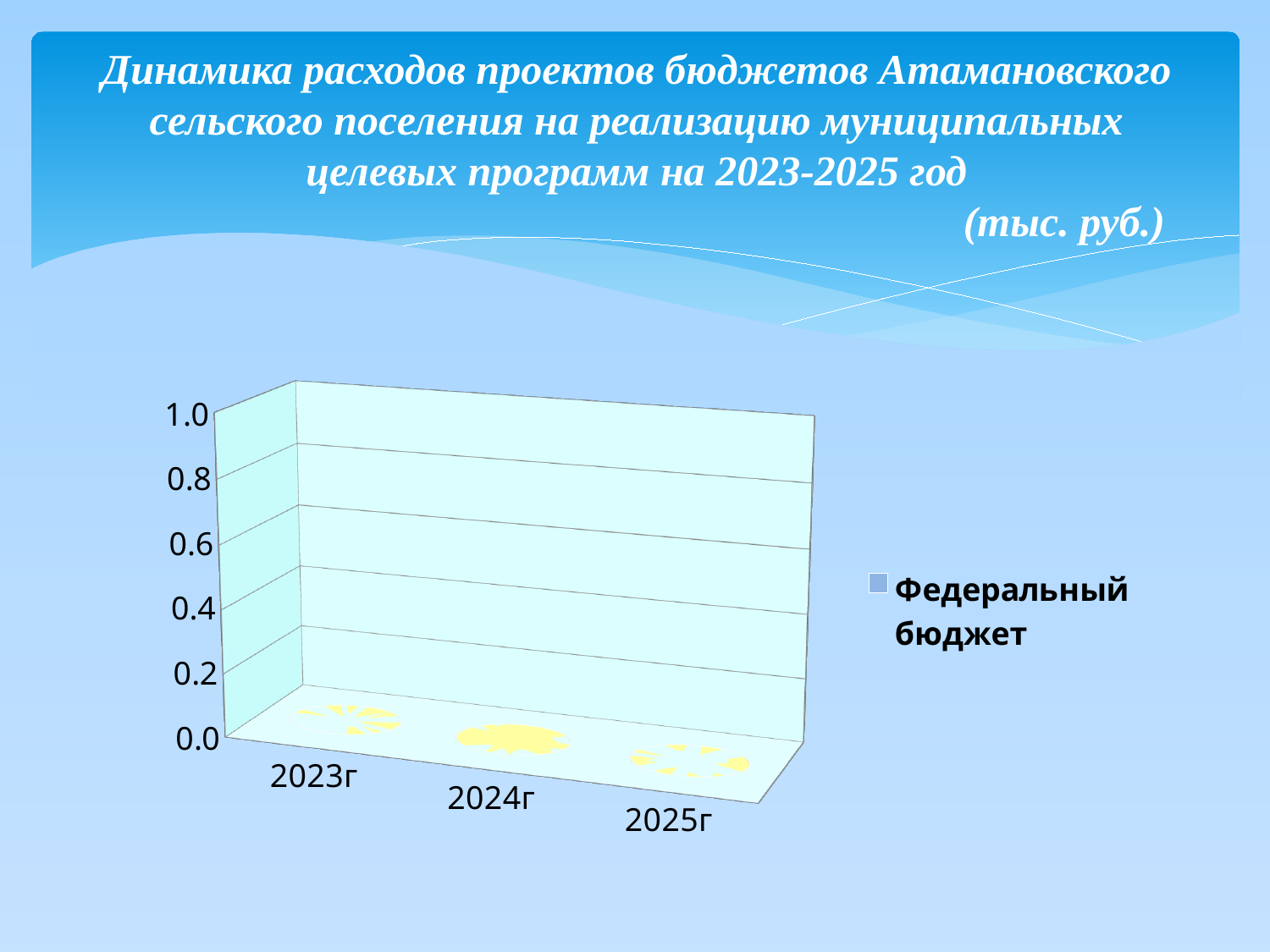
What is the highest value shown on the vertical axis of the chart? 1.0 Is the value for 2025г greater or less than 0.4? less How many categories are shown on the x axis of the chart? 3 Is the value for 2023г greater or less than 0.2? less Is the value for 2024г greater or less than 0.2? less What is the name of the series listed in the chart's legend? Федеральный бюджет Which category label appears first on the x axis of the chart? 2023г How many series does the chart's legend list? 1 What kind of chart is shown on the slide? bar chart